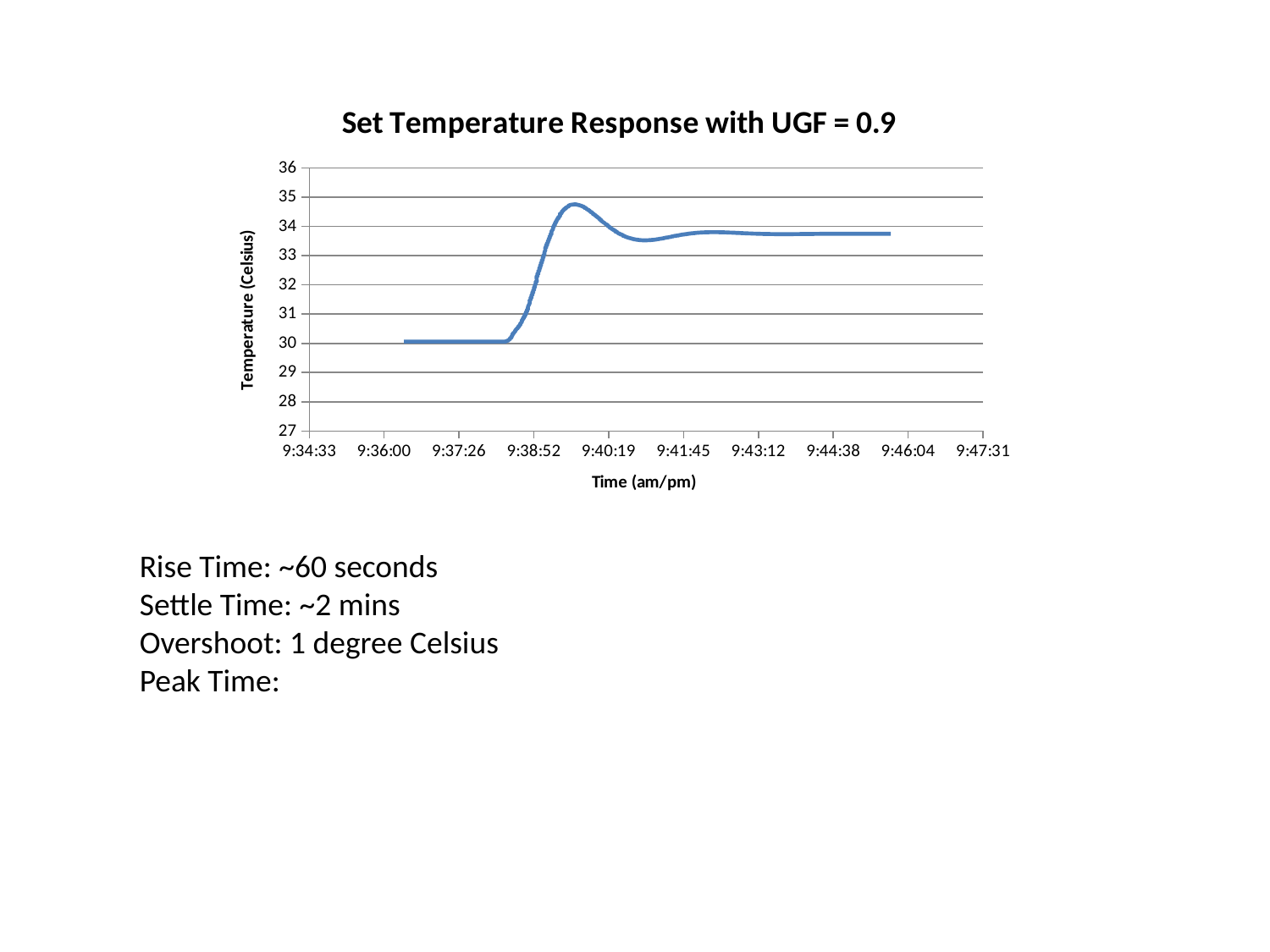
What is the label of the vertical axis of the chart? Temperature (Celsius) Between 9:40:19 and 9:41:45, does the temperature rise or fall? fall Is the temperature at the start of the line (around 9:36:00) greater or less than 31? less What is the title of the chart? Set Temperature Response with UGF = 0.9 Is the temperature at the end of the line (around 9:46:04) greater or less than 33? greater Which time has the higher temperature, 9:37:26 or 9:44:38? 9:44:38 Is the peak temperature reached by the line greater or less than 34? greater Between 9:38:52 and 9:40:19, does the temperature rise or fall? rise What kind of chart is shown on the slide? line chart Which time has the higher temperature, 9:40:19 or 9:36:00? 9:40:19